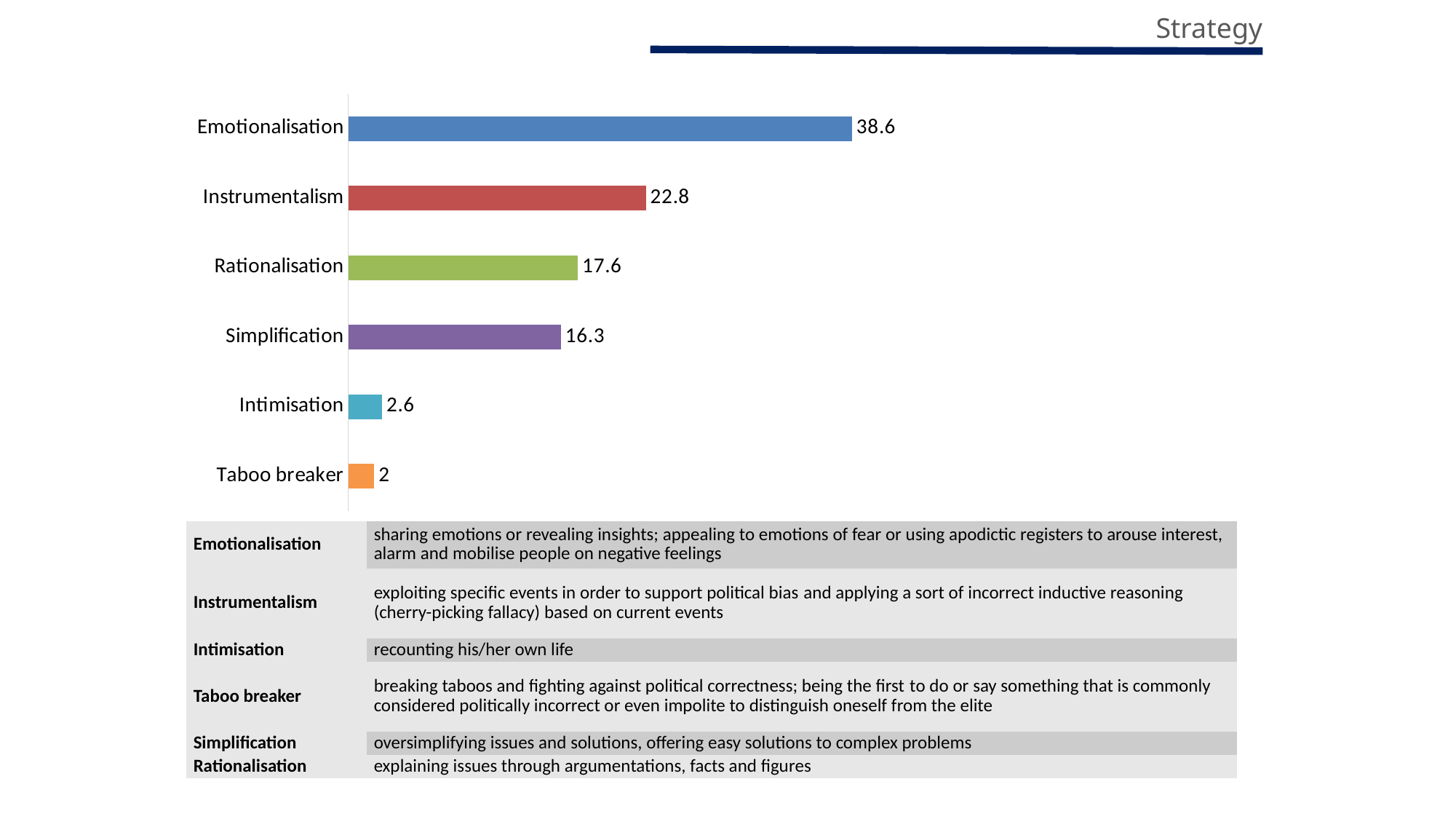
What is the value for Taboo breaker? 2 Which category has the lowest value? Taboo breaker Which is larger, the value for Intimisation or the value for Taboo breaker? Intimisation What is the difference between the values for Rationalisation and Simplification? 1.3 What kind of chart is shown on the slide? Bar chart What is the value for Simplification? 16.3 What is the value for Emotionalisation? 38.6 How many categories are shown in the chart? 6 What is the difference between the values for Emotionalisation and Instrumentalism? 15.8 Which category has the highest value? Emotionalisation What colour is the bar for Rationalisation? Green What is the value for Instrumentalism? 22.8